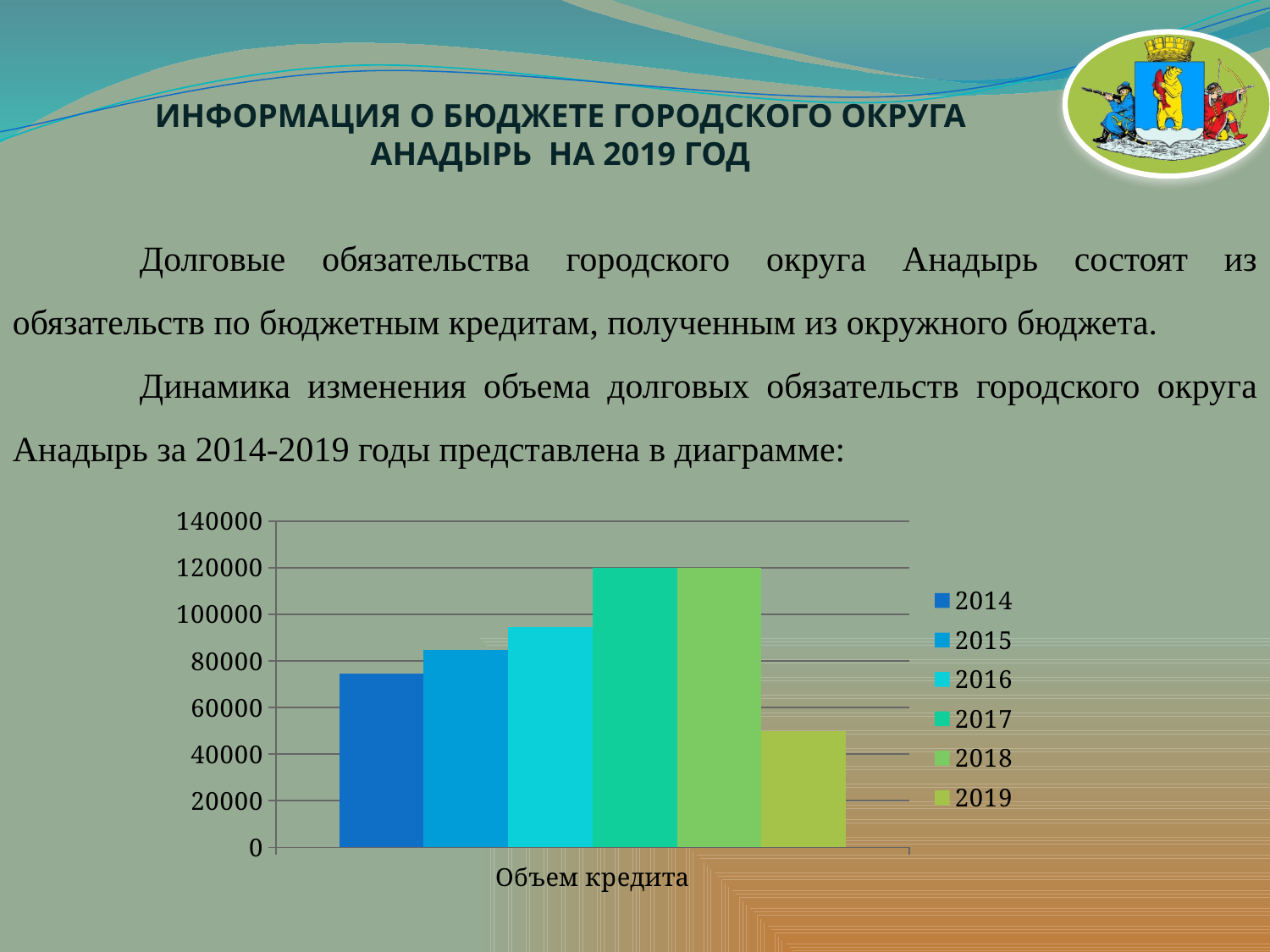
Is the value for 2016 greater or less than 100000? less How many series does the legend of the chart list? 6 Is the value for 2019 greater or less than 60000? less Which is larger, the value for 2016 or the value for 2019? 2016 What kind of chart is shown on the slide? bar chart What is the category label shown on the x axis of the chart? Объем кредита Which year has the lowest value in the chart? 2019 Is the value for 2015 greater or less than 80000? greater Which is larger, the value for 2014 or the value for 2015? 2015 How many categories are shown on the x axis of the chart? 1